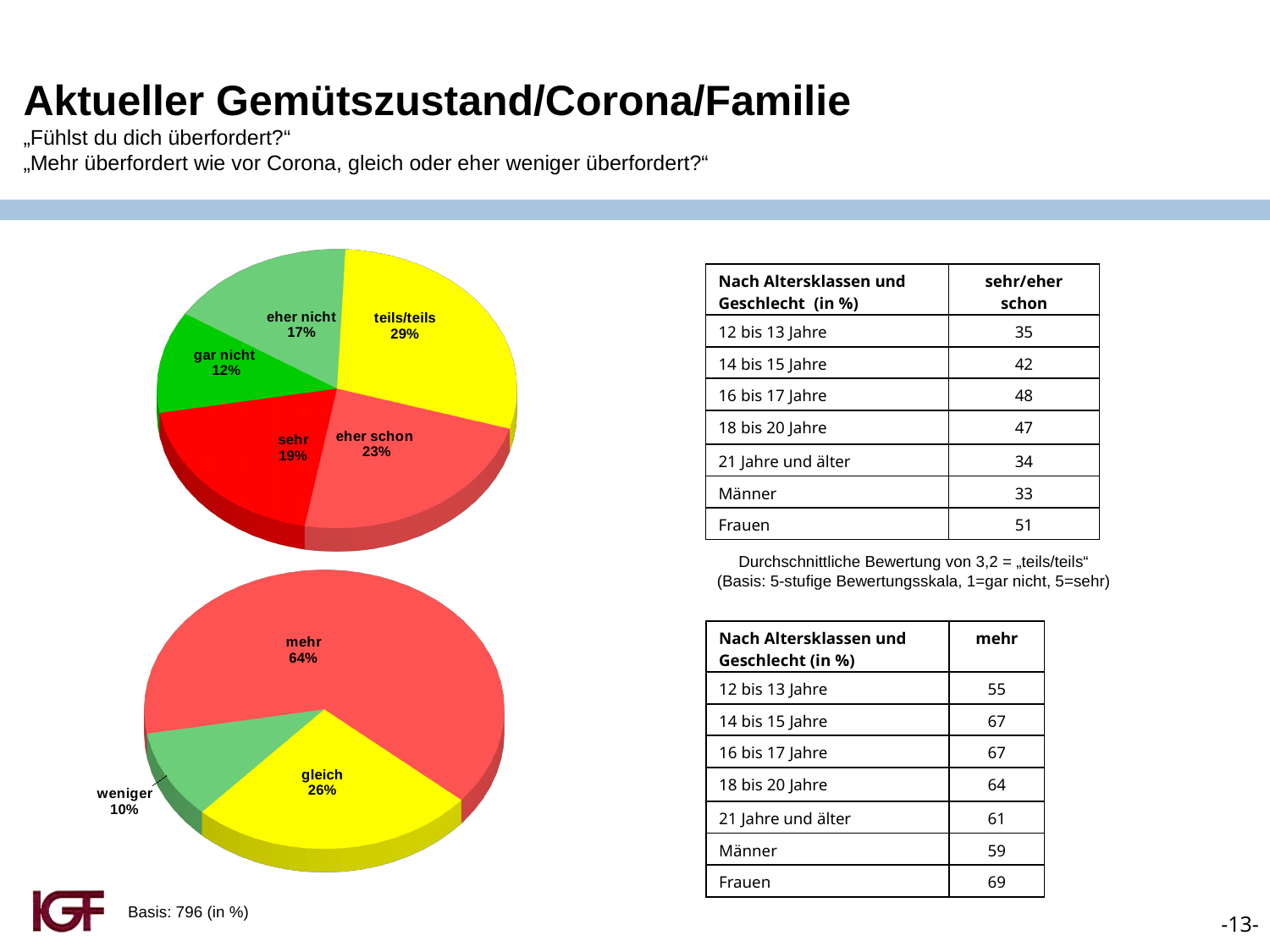
In the top pie chart, which category has the smallest share? gar nicht In the top pie chart, what is the difference between "eher schon" and "sehr"? 4% In the bottom pie chart, what is the value for "mehr"? 64% In the bottom pie chart, what is the value for "weniger"? 10% In the top pie chart, what is the value for "teils/teils"? 29% In the top pie chart, which category has the largest share? teils/teils How many slices does the bottom pie chart have? 3 What type of chart is the bottom chart on the slide? pie chart How many slices does the top pie chart have? 5 In the bottom pie chart, what is the difference between "mehr" and "gleich"? 38% In the top pie chart, what is the value for "gar nicht"? 12% In the top pie chart, which is larger, "eher nicht" or "sehr"? sehr